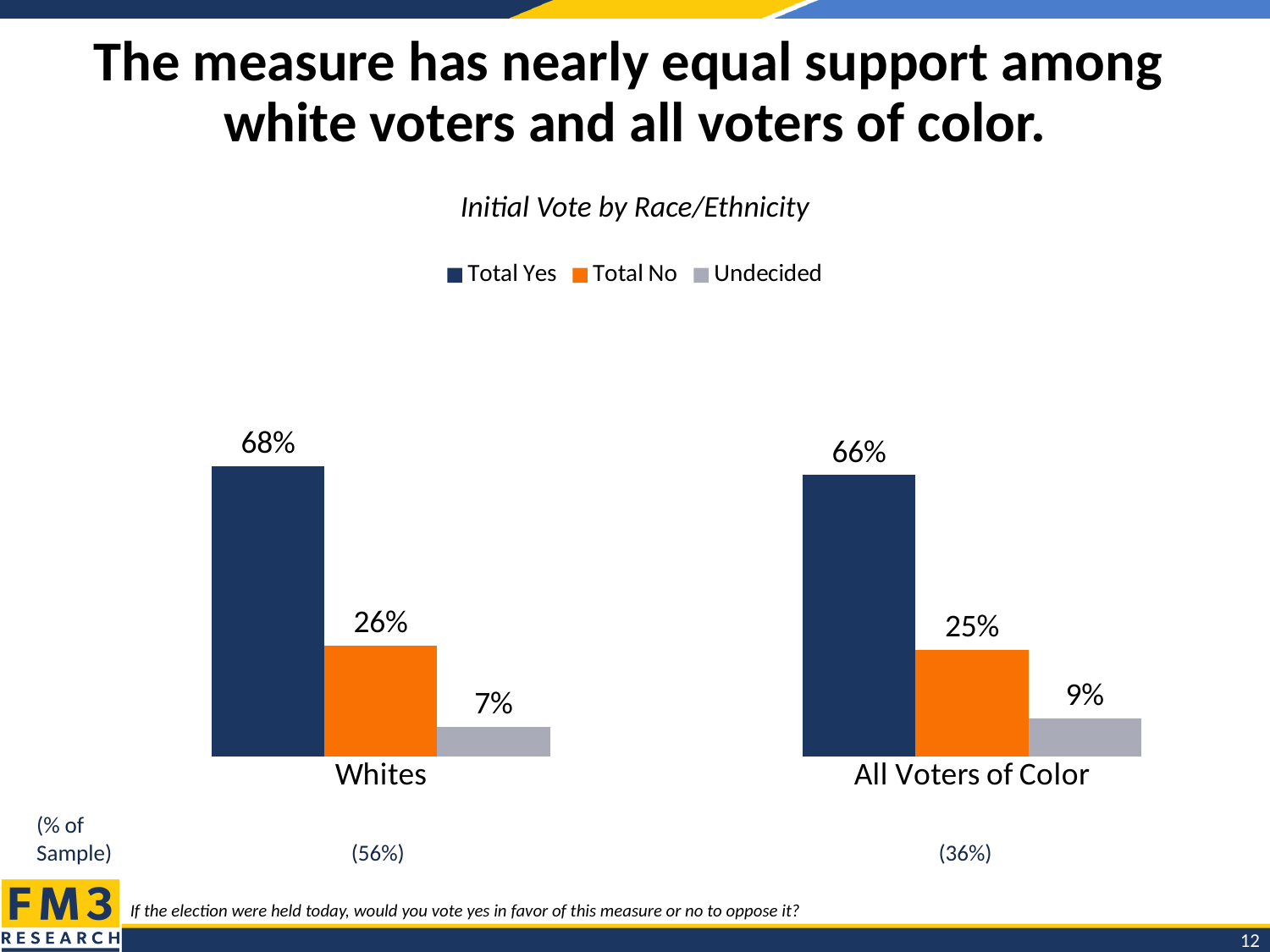
How many categories are shown on the x axis? 2 What is the Undecided value for Whites? 7% What is the Total No value for All Voters of Color? 25% What is the Total Yes value for Whites? 68% What is the difference between Total Yes and Total No for Whites? 42% What is the difference between the Total Yes values for Whites and All Voters of Color? 2% What kind of chart is shown on the slide? bar chart Which category has the higher Total Yes value? Whites Which category has the lower Undecided value? Whites What is the Total Yes value for All Voters of Color? 66% Is the Undecided value for All Voters of Color larger or smaller than the Undecided value for Whites? larger How many series does the legend list? 3